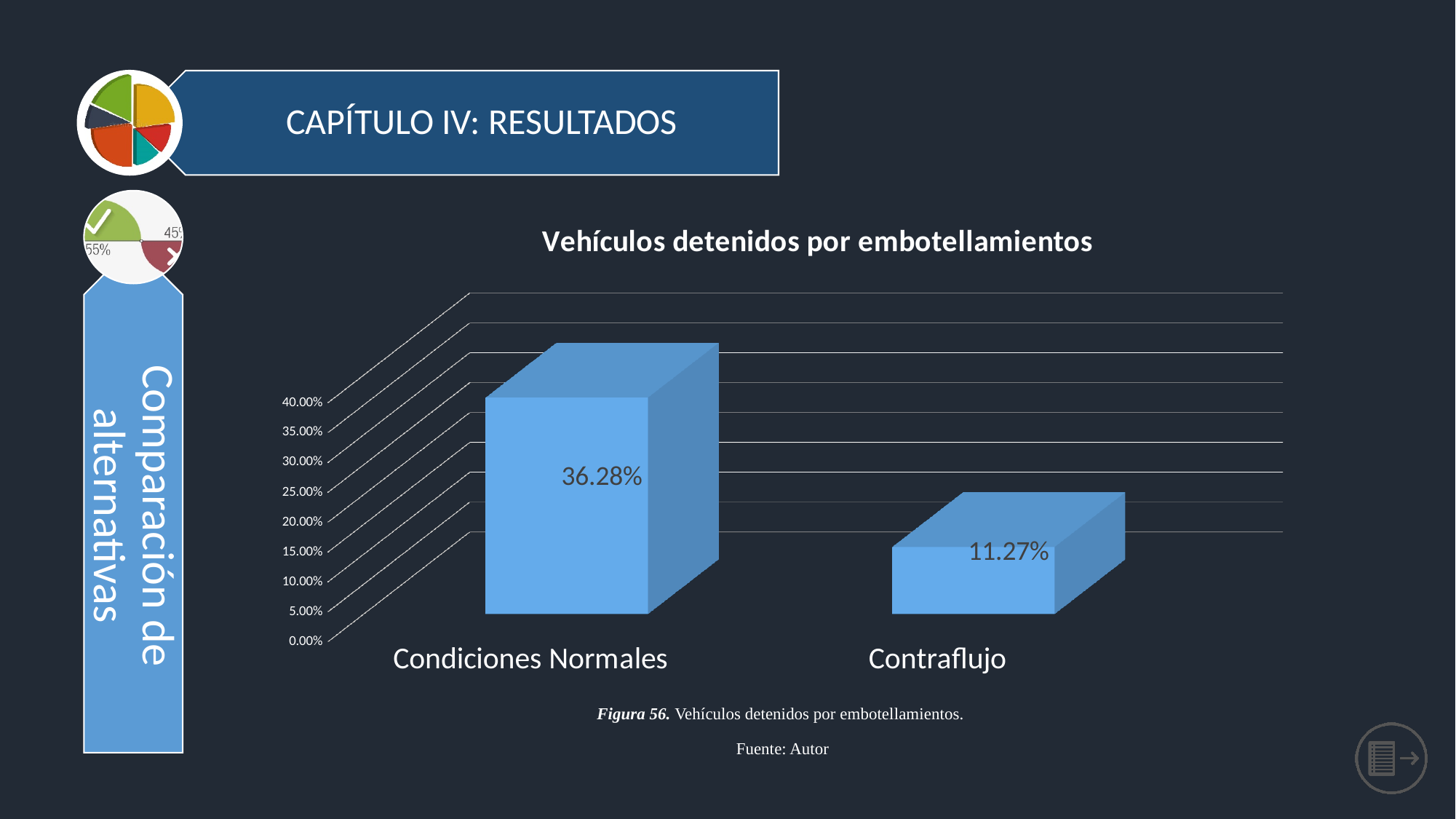
What is the value for Condiciones Normales? 36.28% What is the highest value labelled on the vertical axis? 40.00% What kind of chart is shown on the slide? bar chart Which is larger, the value for Condiciones Normales or the value for Contraflujo? Condiciones Normales Is the value for Contraflujo greater or less than 15.00%? less What is the title of the chart? Vehículos detenidos por embotellamientos Which category has the highest value? Condiciones Normales Is the value for Condiciones Normales greater or less than 30.00%? greater What is the difference between the values for Condiciones Normales and Contraflujo? 25.01% How many categories are shown in the chart? 2 What is the value for Contraflujo? 11.27% Which category has the lowest value? Contraflujo